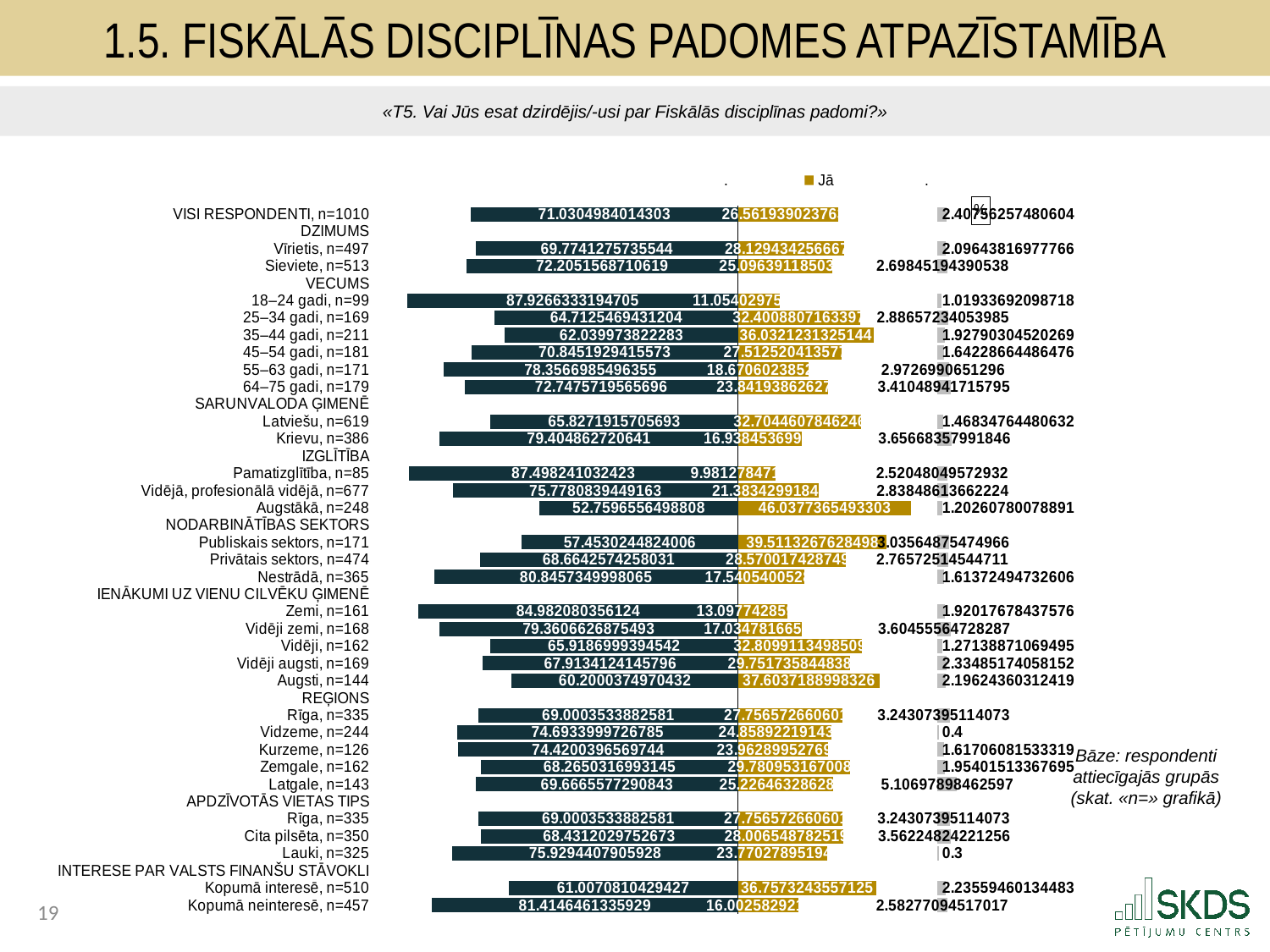
Which group has the lowest "Jā" value? Pamatizglītība, n=85 Which survey question is the chart based on, as quoted under the slide title? «T5. Vai Jūs esat dzirdējis/-usi par Fiskālās disciplīnas padomi?» What is the difference between the "Jā" values for Kopumā interesē, n=510 and Sieviete, n=513? 11.6609331706825 What is the difference between the "Jā" values for Augstākā, n=248 and Vidēji, n=162? 13.2278251994794 What is the "Jā" value for Zemgale, n=162? 29.780953167008 What is the "Jā" value for Sieviete, n=513? 25.09639118503 Which has the larger "Jā" value: Augsti, n=144 or Zemi, n=161? Augsti, n=144 What is the "Jā" value for 35–44 gadi, n=211? 36.0321231325144 What is the "Jā" value for Augstākā, n=248? 46.0377365493303 What is the "Jā" value for Kopumā interesē, n=510? 36.7573243557125 Which group has the highest "Jā" value? Augstākā, n=248 What kind of chart is shown on the slide? Stacked horizontal bar chart